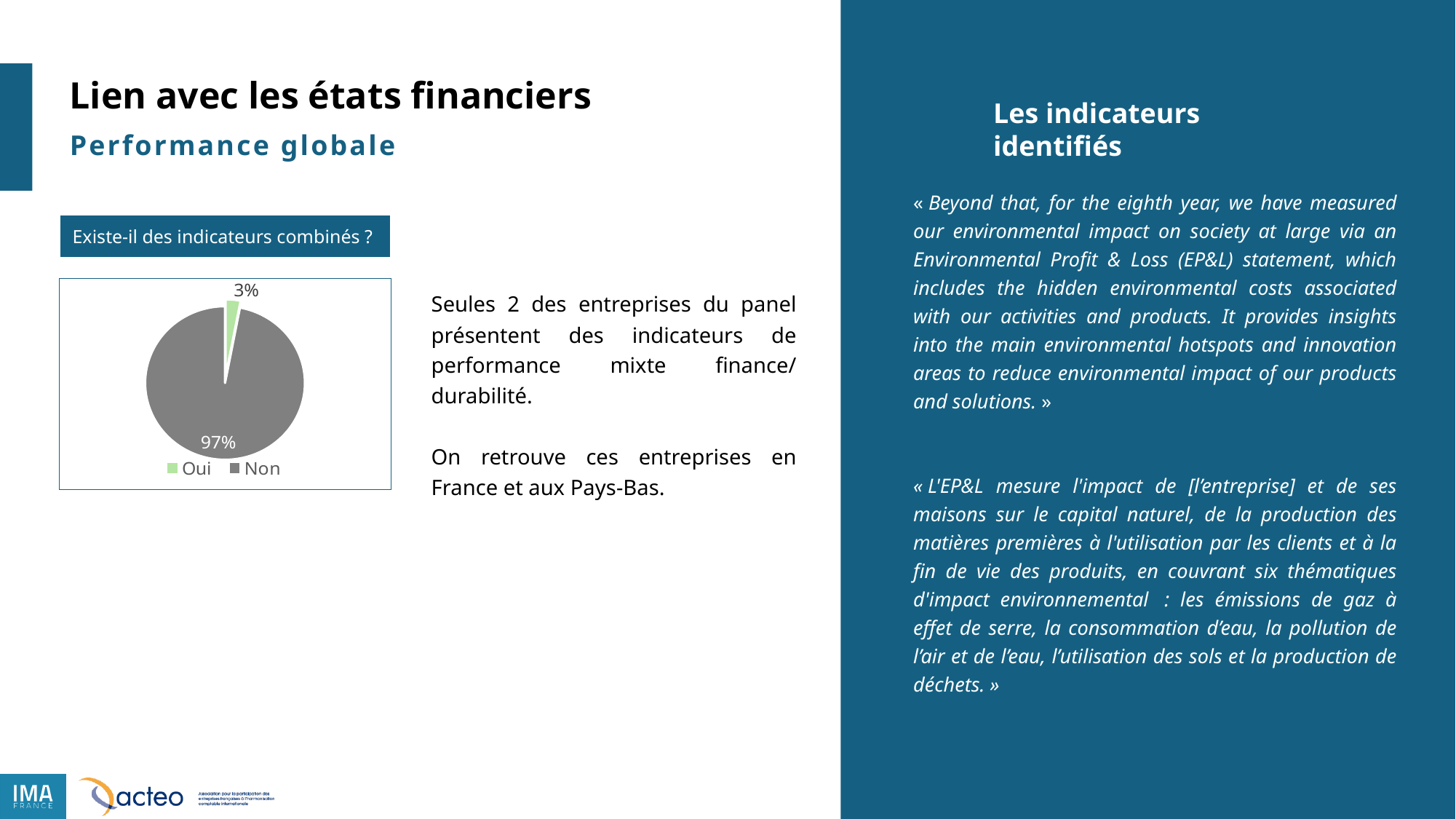
What colour is the "Oui" slice of the pie chart? green Which slice of the pie is the smallest? Oui What share of the pie is labelled "Non"? 97% How many slices does the pie chart have? 2 What kind of chart is shown on the slide? pie chart Which slice of the pie is the largest? Non What share of the pie is labelled "Oui"? 3% What is the difference in percentage points between the "Non" and "Oui" slices? 94 Which is larger, the "Oui" slice or the "Non" slice? Non How many entries does the legend of the pie chart list? 2 What is the title shown above the pie chart? Existe-il des indicateurs combinés ?